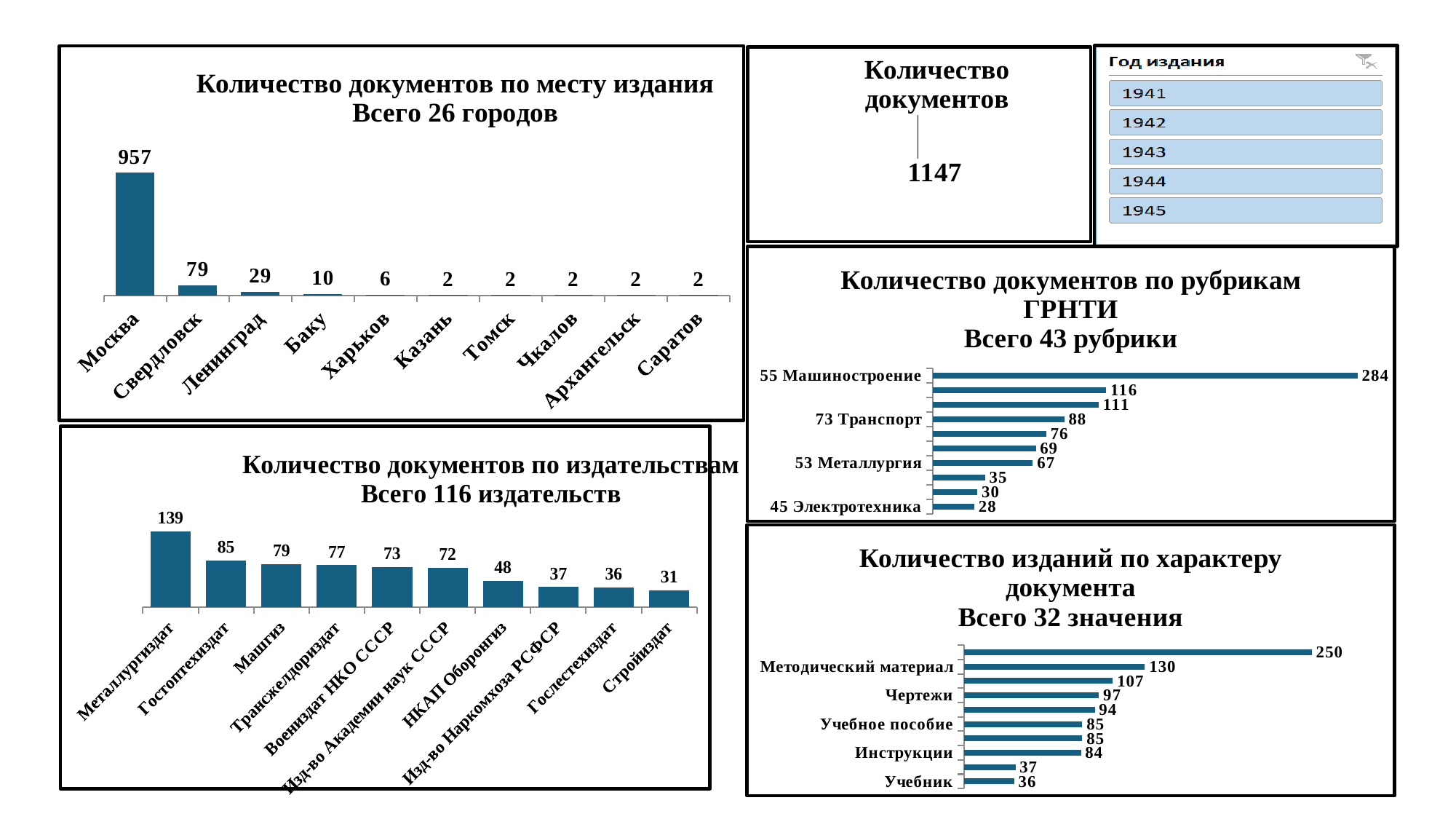
In the chart 'Количество документов по издательствам', which publisher has the lowest value? Стройиздат In the chart 'Количество документов по рубрикам ГРНТИ', what is the difference between 53 Металлургия and 45 Электротехника? 39 In the chart 'Количество документов по рубрикам ГРНТИ', what is the value for 55 Машиностроение? 284 In the chart 'Количество документов по месту издания', how many cities are plotted? 10 In the chart 'Количество документов по рубрикам ГРНТИ', what is the value for 73 Транспорт? 88 What type of chart is 'Количество изданий по характеру документа'? Bar chart In the chart 'Количество документов по месту издания', which city has the highest number of documents? Москва In the chart 'Количество документов по издательствам', what is the value for Машгиз? 79 In the chart 'Количество изданий по характеру документа', what is the value for Методический материал? 130 In the chart 'Количество документов по издательствам', which is larger: Гостоптехиздат or Трансжелдориздат? Гостоптехиздат In the chart 'Количество документов по месту издания', how many documents are from Москва? 957 In the chart 'Количество документов по месту издания', what is the difference between Свердловск and Ленинград? 50